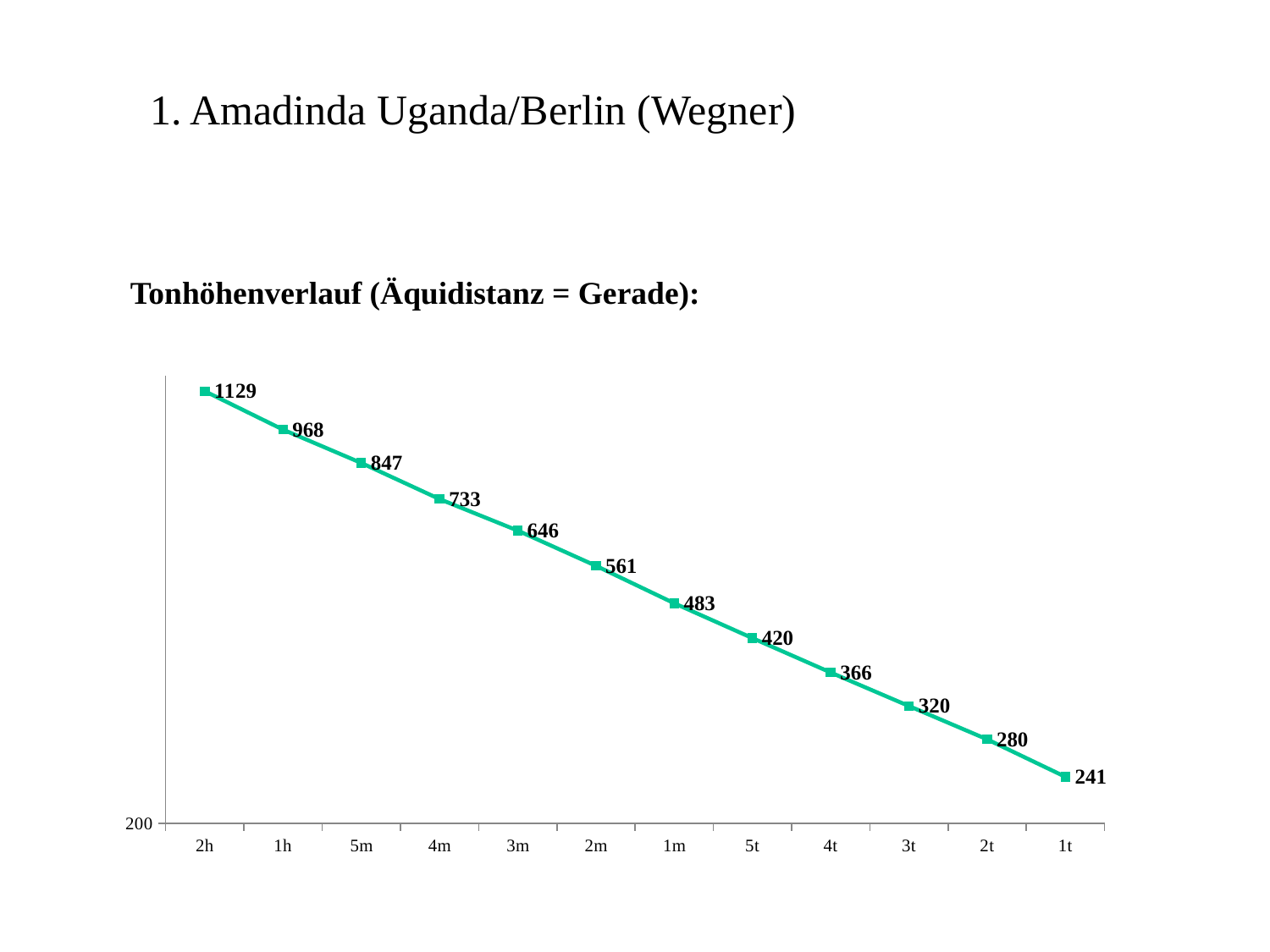
What is the value for 2h? 1129 What is the difference between the values for 1h and 5m? 121 Which category has the highest value? 2h How many data points are plotted on the chart? 12 Which is larger, the value for 4t or the value for 2t? 4t What kind of chart is shown on the slide? line chart Do the values rise or fall from left to right along the x axis? fall What is the value for 5t? 420 What is the difference between the values for 2h and 1t? 888 What is the value for 1t? 241 Which category has the lowest value? 1t What is the value for 3m? 646